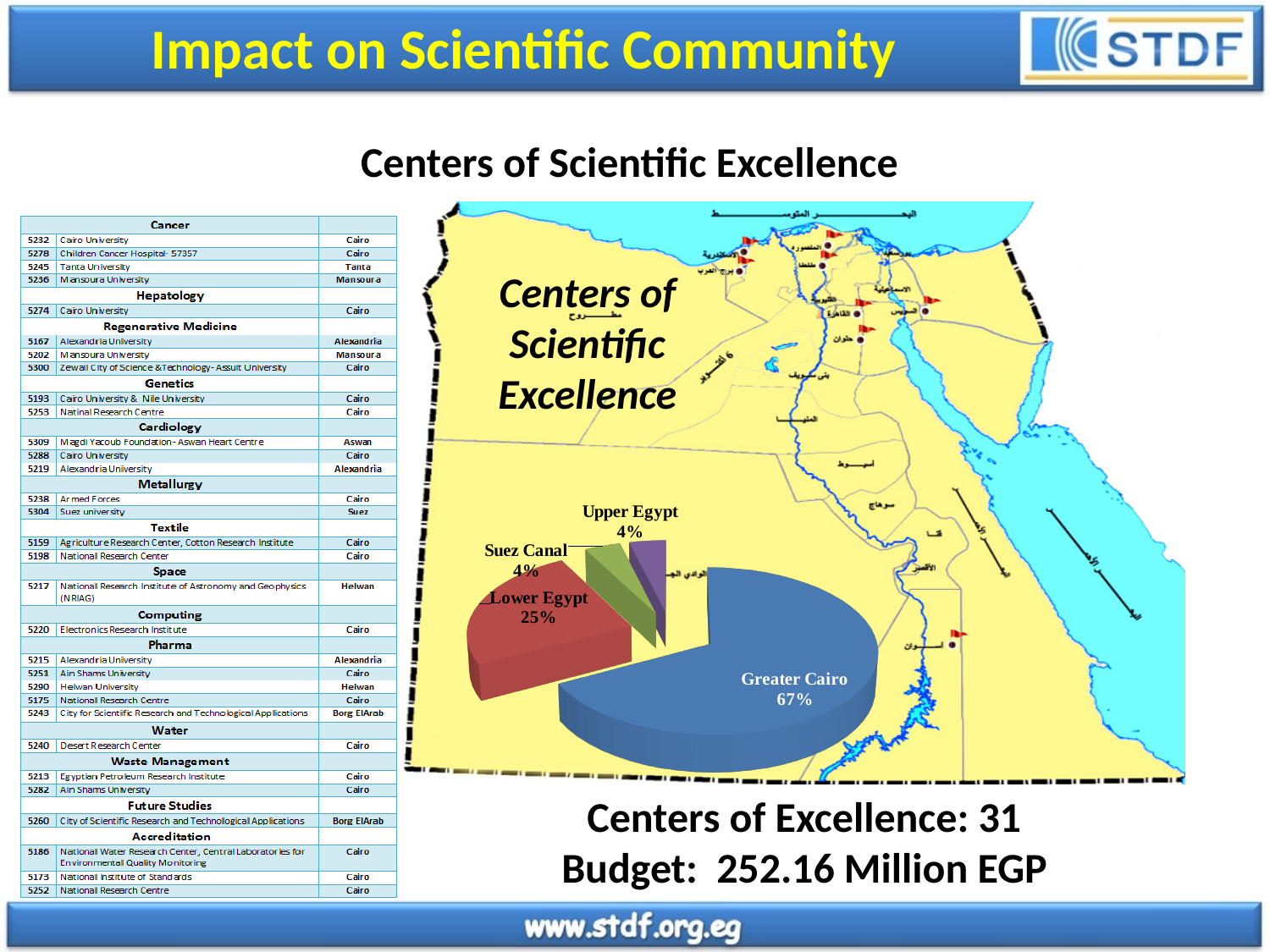
How many slices does the pie chart have? 4 Which region has the largest slice in the pie chart? Greater Cairo What is the difference in percentage points between Greater Cairo and Lower Egypt in the pie chart? 42 What kind of chart is overlaid on the map of Egypt? pie chart What share of the pie chart does Greater Cairo represent? 67% What is the combined share of Suez Canal and Upper Egypt in the pie chart? 8% What colour is the Greater Cairo slice in the pie chart? blue Which is larger in the pie chart, Lower Egypt or Suez Canal? Lower Egypt What share of the pie chart does Upper Egypt represent? 4% What share of the pie chart does Lower Egypt represent? 25% What title is written on the map above the pie chart? Centers of Scientific Excellence